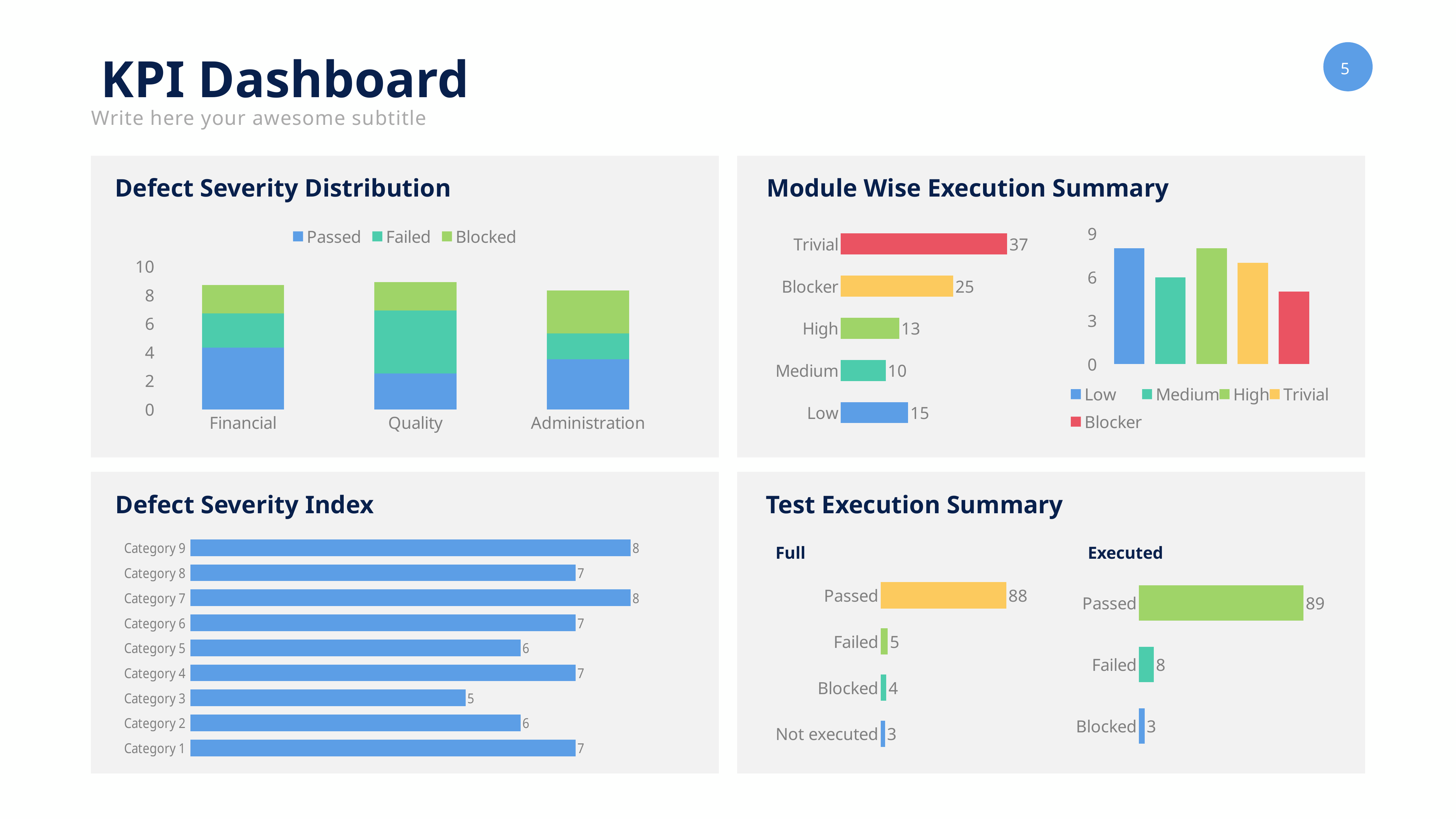
In the Module Wise Execution Summary horizontal bar chart, what is the difference between Blocker and High? 12 In the Defect Severity Index chart, what is the value for Category 3? 5 In the Test Execution Summary, what is the value for Passed in the Full chart? 88 In the Defect Severity Distribution chart, is the Passed value for Financial greater or less than 2? greater In the Module Wise Execution Summary horizontal bar chart, what is the value for Trivial? 37 In the Defect Severity Index chart, how many categories are plotted? 9 How many series does the legend of the Defect Severity Distribution chart list? 3 In the Module Wise Execution Summary horizontal bar chart, which category has the lowest value? Medium What kind of chart is the Defect Severity Distribution chart? Stacked bar chart In the Defect Severity Index chart, which is larger, Category 5 or Category 7? Category 7 In the Test Execution Summary, what is the value for Failed in the Executed chart? 8 In the Test Execution Summary Full chart, what is the difference between Failed and Not executed? 2